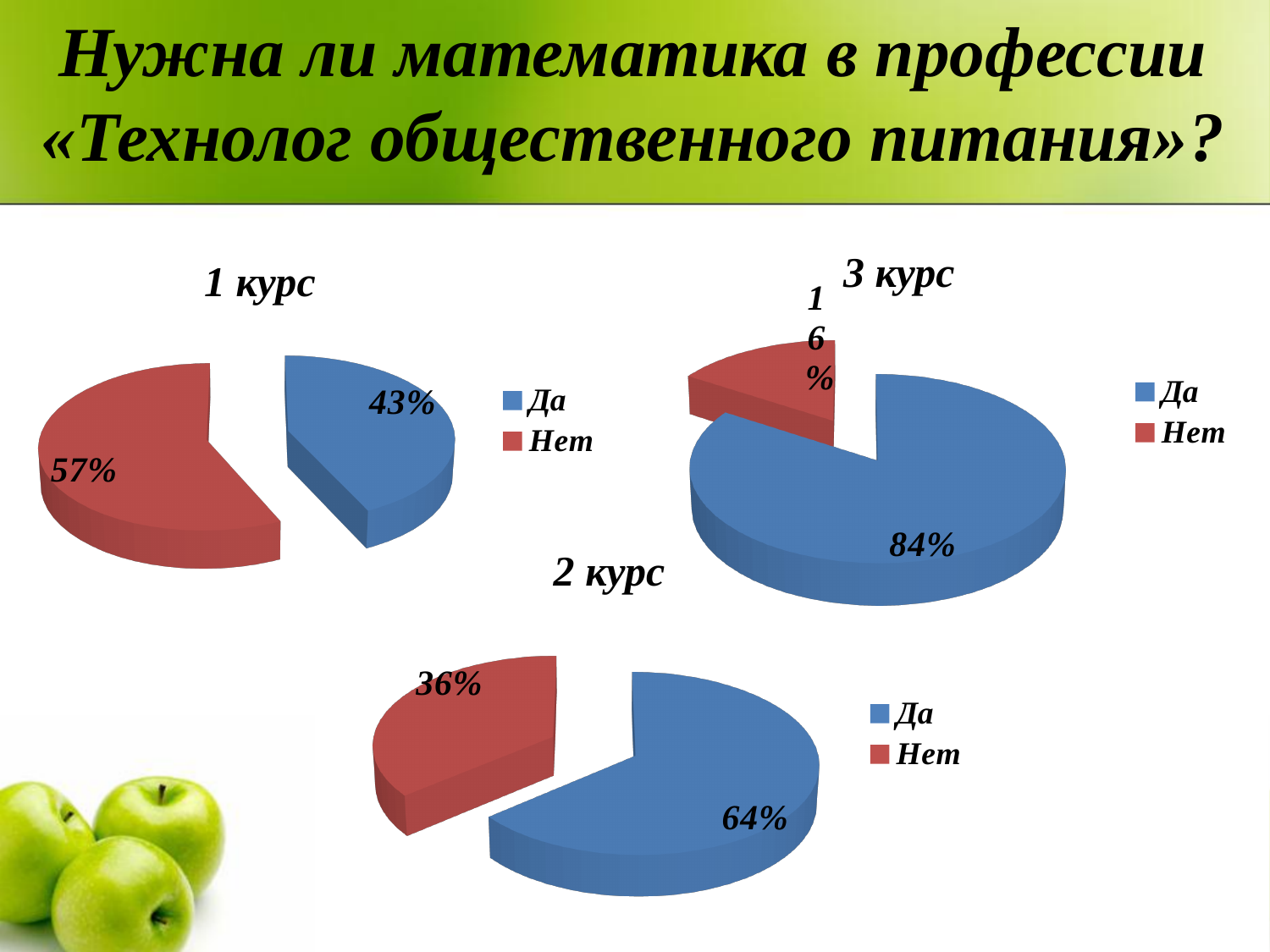
How many series does the legend of the "1 курс" chart list? 2 In the "3 курс" chart, which category has the smallest slice? Нет In the "3 курс" chart, what is the value for "Нет"? 16% In the "3 курс" chart, what is the value for "Да"? 84% Which is larger: "Да" in the "1 курс" chart or "Да" in the "3 курс" chart? Да in the 3 курс chart In the "1 курс" chart, what is the value for "Нет"? 57% In the "2 курс" chart, what is the value for "Да"? 64% In the "1 курс" chart, which category has the largest slice? Нет What type of chart is the "2 курс" chart? Pie chart In the "2 курс" chart, what is the value for "Нет"? 36% In the "2 курс" chart, what is the difference between the "Да" and "Нет" values? 28% In the "1 курс" chart, what is the value for "Да"? 43%